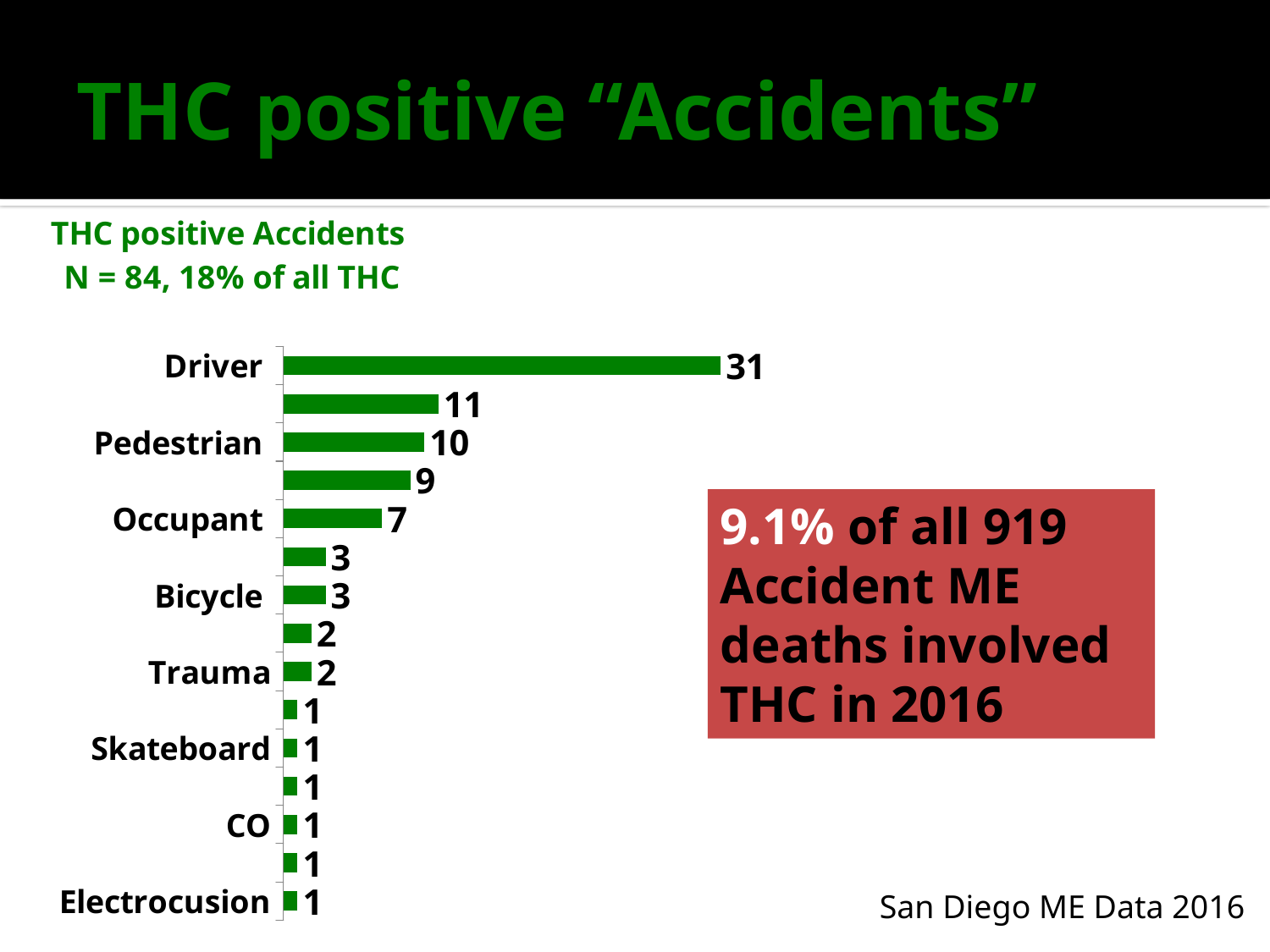
Which category has the highest value? Driver What is the value for Driver? 31 What kind of chart is shown on the slide? Bar chart What is the title of the chart? THC positive Accidents N = 84, 18% of all THC How many bars are plotted in the chart? 15 What is the difference between the values for Driver and Pedestrian? 21 What is the value for Bicycle? 3 What is the value for Pedestrian? 10 What is the value for Trauma? 2 What is the value for Occupant? 7 Which is larger, the value for Pedestrian or the value for Occupant? Pedestrian What is the difference between the values for Occupant and Bicycle? 4